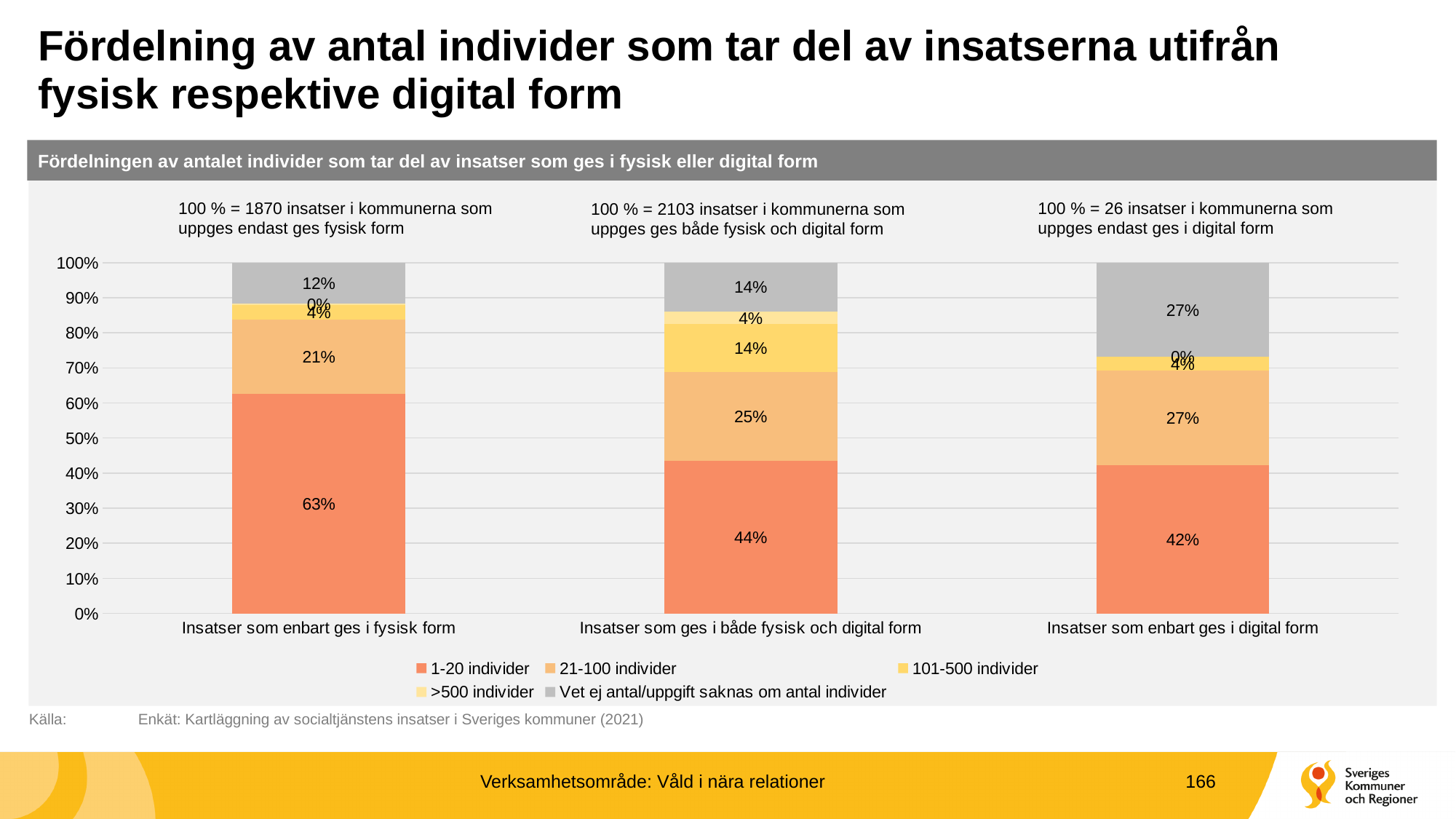
What is the share of '101-500 individer' for 'Insatser som ges i både fysisk och digital form'? 14% Which category has the highest share of '1-20 individer'? Insatser som enbart ges i fysisk form Which category has the lowest share of 'Vet ej antal/uppgift saknas om antal individer'? Insatser som enbart ges i fysisk form How many series does the legend list? 5 What is the share of 'Vet ej antal/uppgift saknas om antal individer' for 'Insatser som enbart ges i digital form'? 27% Which is larger: the '21-100 individer' share for 'Insatser som enbart ges i digital form' or for 'Insatser som enbart ges i fysisk form'? Insatser som enbart ges i digital form What is the difference in the '1-20 individer' share between 'Insatser som enbart ges i fysisk form' and 'Insatser som ges i både fysisk och digital form'? 19 percentage points According to the note above the chart, how many insatser does 100 % correspond to for the category given only in digital form? 26 How many categories are shown on the x axis of the chart? 3 What is the share of '21-100 individer' for 'Insatser som ges i både fysisk och digital form'? 25% What kind of chart is shown on the slide? Stacked bar chart What is the share of '1-20 individer' for 'Insatser som enbart ges i fysisk form'? 63%